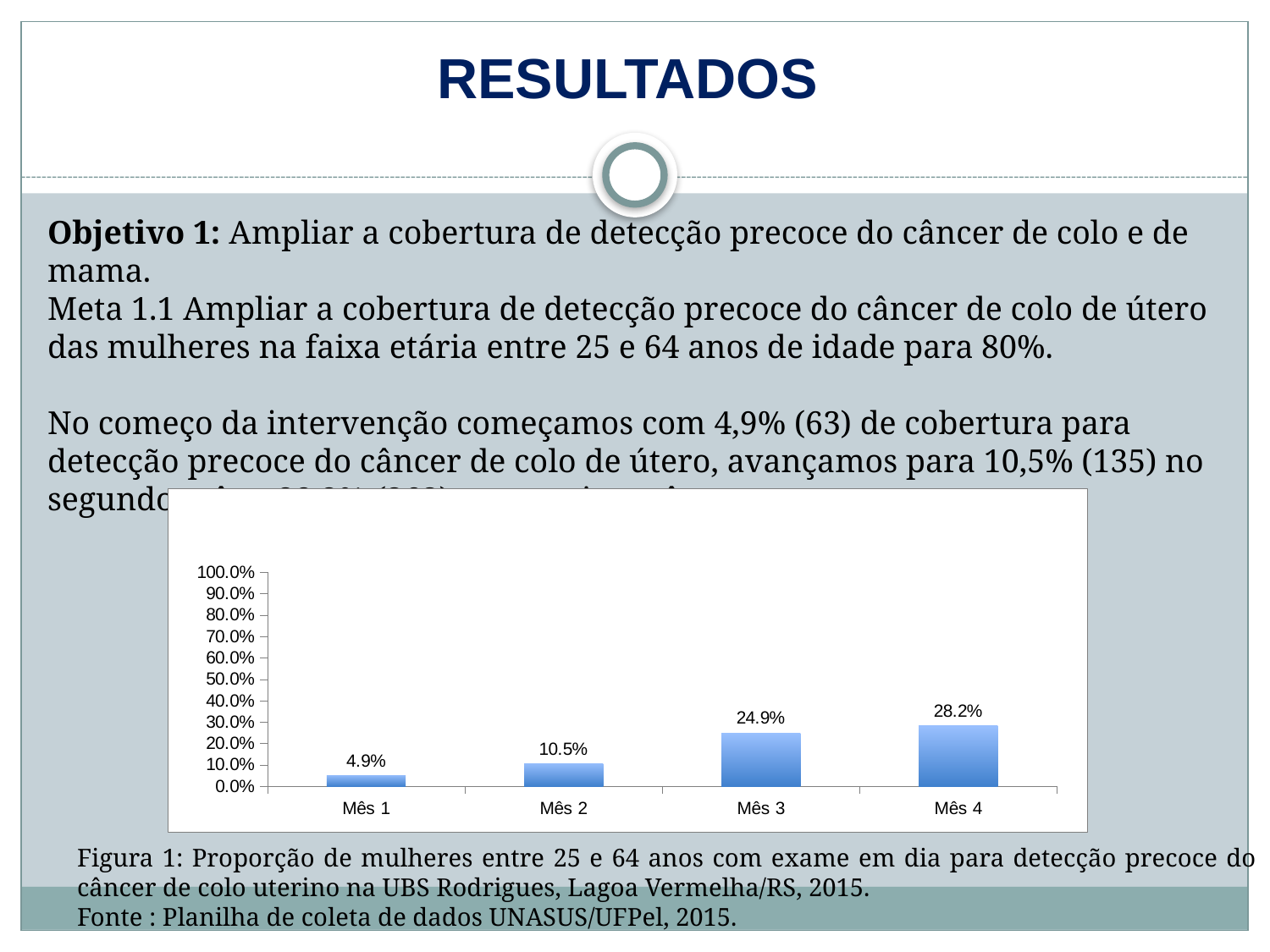
What is the value for Mês 3? 24.9% Which month has the lowest value? Mês 1 What is the difference between the values for Mês 4 and Mês 1? 23.3% What kind of chart is shown on the slide? bar chart What is the value for Mês 1? 4.9% What is the difference between the values for Mês 3 and Mês 2? 14.4% How many months are shown on the x axis? 4 Do the values rise or fall from Mês 1 to Mês 4? rise Which month has the highest value? Mês 4 Which is larger, the value for Mês 2 or the value for Mês 3? Mês 3 Is the value for Mês 4 greater or less than 30.0%? less What is the value for Mês 4? 28.2%